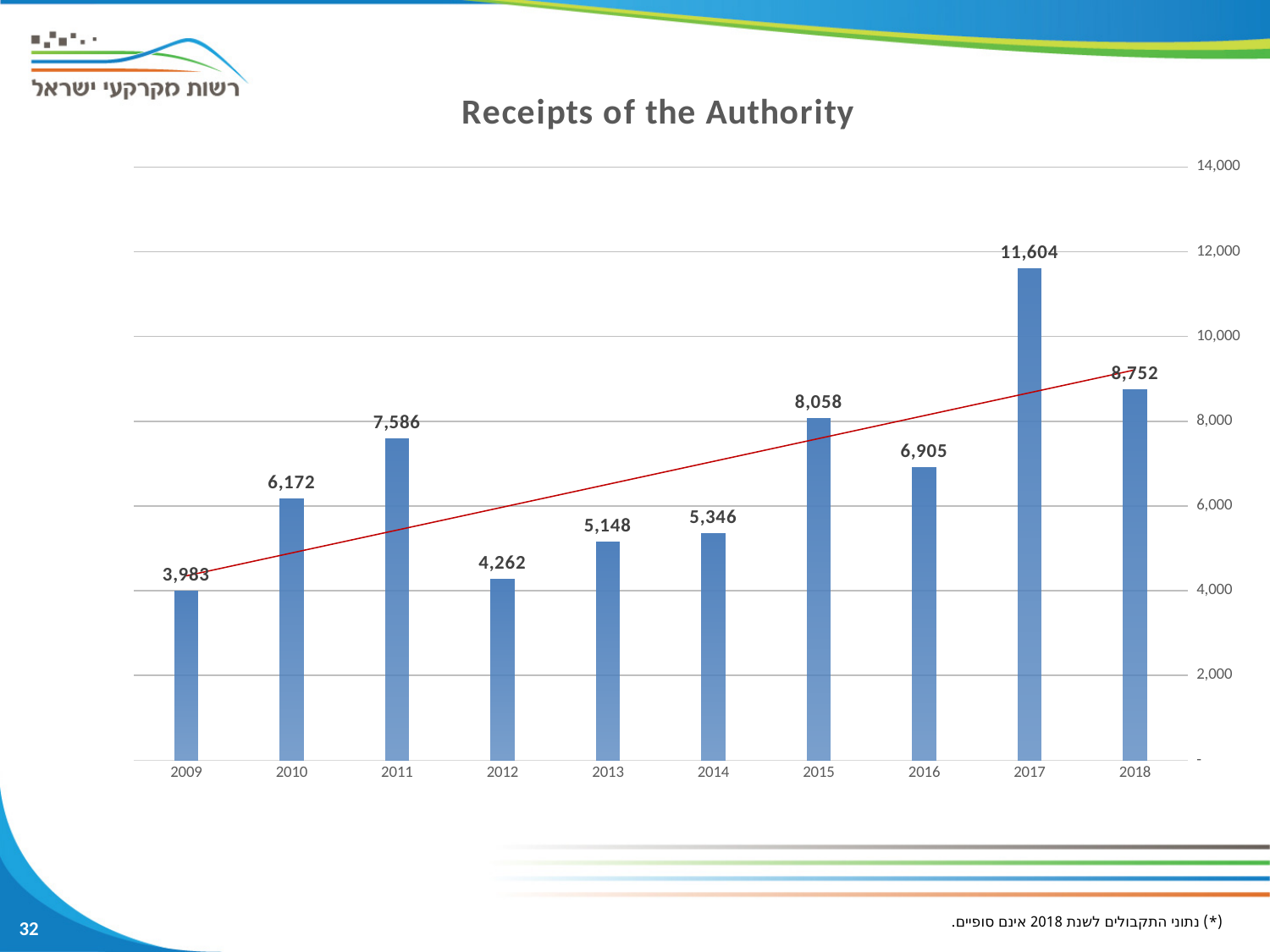
What is the value for 2017? 11,604 What is the value for 2012? 4,262 Is the value for 2014 greater or less than 6,000? less What is the difference between the values for 2011 and 2012? 3,324 Which year has the highest value? 2017 Which year has the lowest value? 2009 What is the difference between the values for 2017 and 2018? 2,852 Which is larger, the value for 2015 or the value for 2016? 2015 What is the title of the chart? Receipts of the Authority What is the value for 2018? 8,752 How many years are shown on the x axis? 10 What kind of chart is shown on the slide? bar chart